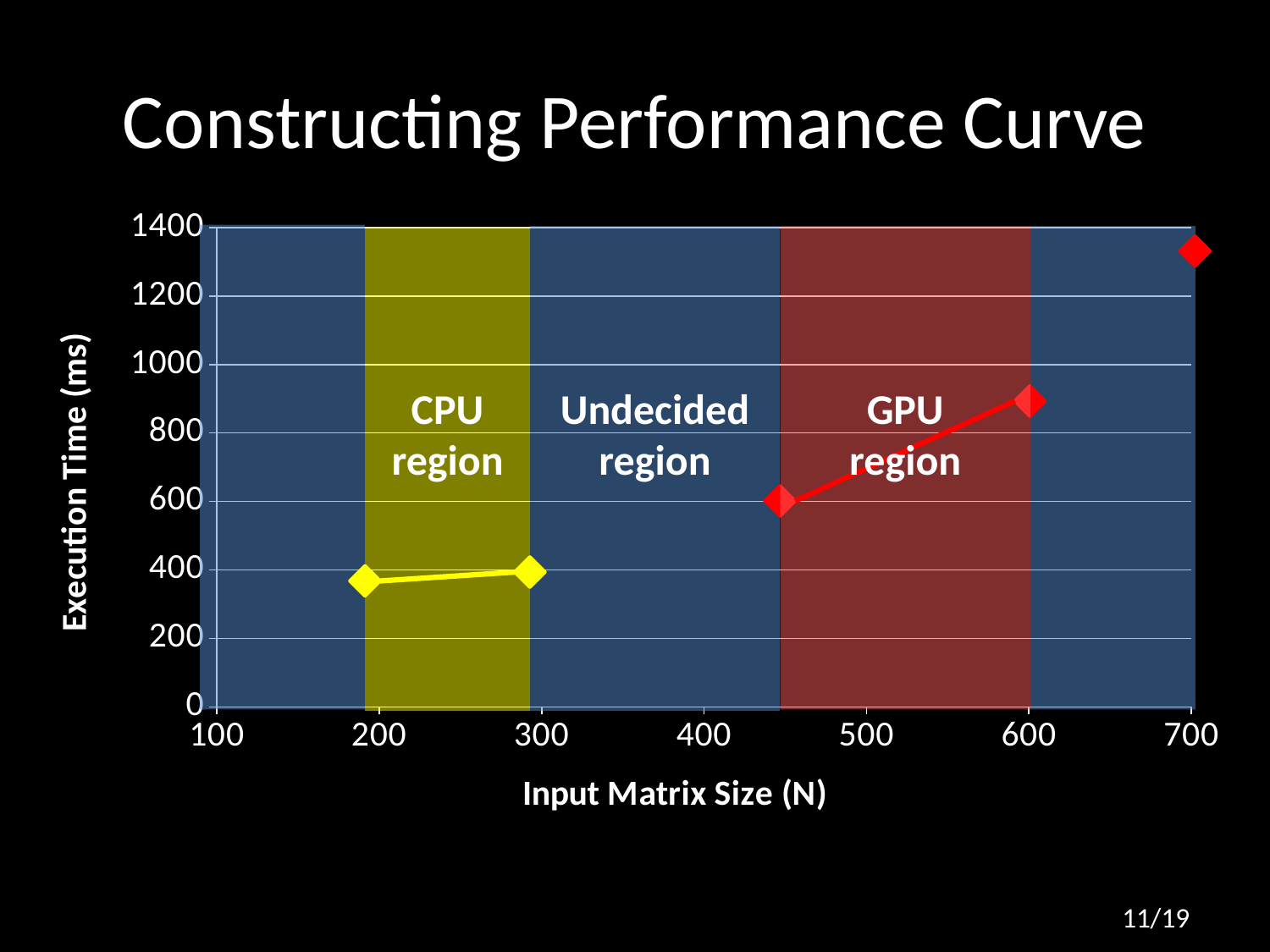
Is the execution time at input matrix size 450 greater or less than 800 ms? less What kind of chart is shown on the slide? line chart What is the title of the slide's chart? Constructing Performance Curve Is the execution time at input matrix size 600 greater or less than 800 ms? greater Which has the larger execution time, input matrix size 200 or input matrix size 700? 700 Is the execution time at input matrix size 300 greater or less than 600 ms? less Which has the larger execution time, input matrix size 450 or input matrix size 600? 600 Does execution time rise or fall as input matrix size increases along the x axis? rise Which input matrix size has the highest execution time? 700 What is the label of the x axis? Input Matrix Size (N) How many data points are plotted on the chart? 5